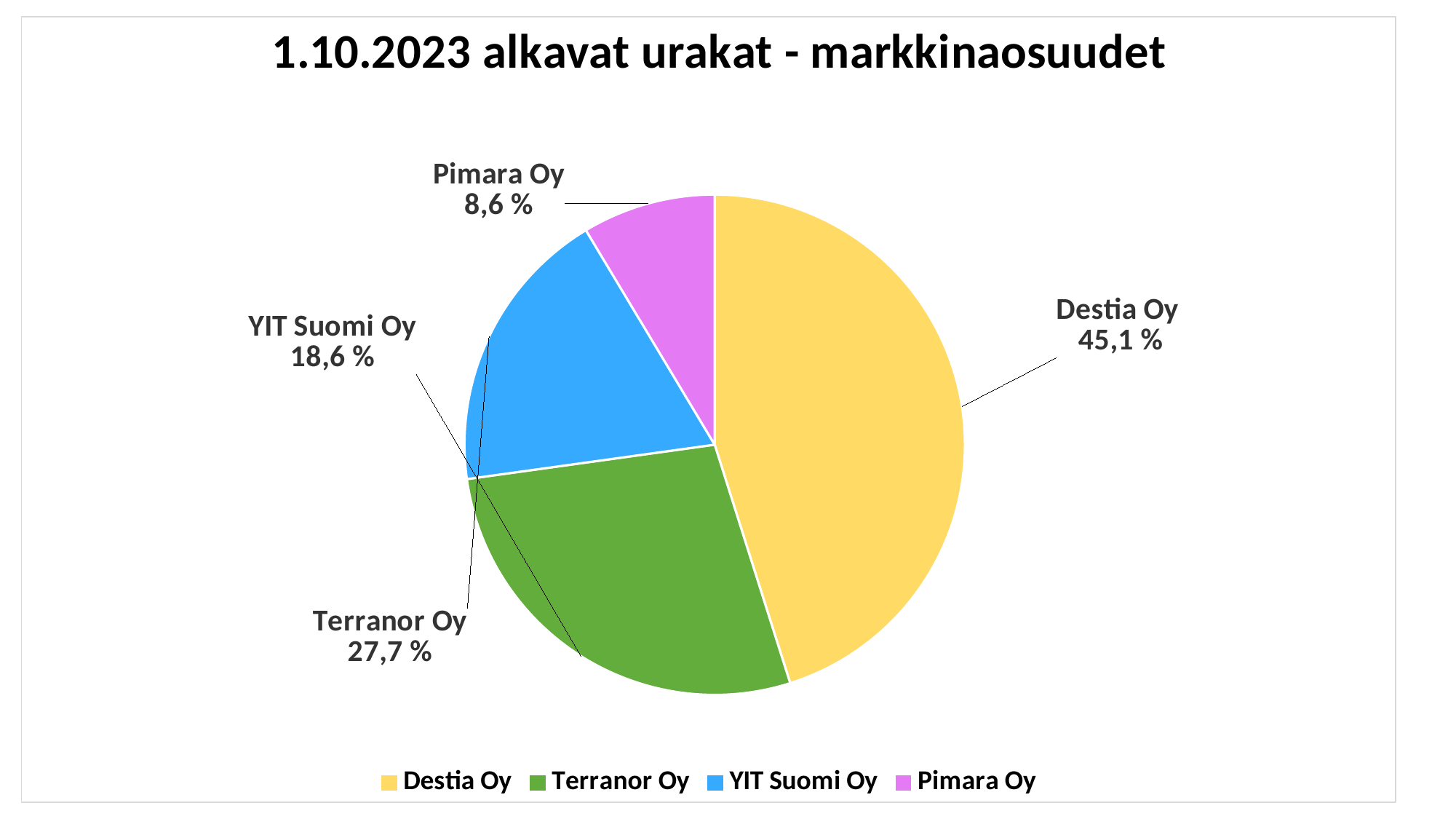
What kind of chart is shown on the slide? Pie chart Which company has the largest slice of the pie? Destia Oy Which has a larger share, YIT Suomi Oy or Terranor Oy? Terranor Oy Which company has the smallest slice of the pie? Pimara Oy What is the title of the chart? 1.10.2023 alkavat urakat - markkinaosuudet What is the market share shown for Destia Oy? 45,1 % Which colour represents YIT Suomi Oy in the chart? Blue What is the market share shown for Pimara Oy? 8,6 % What is the market share shown for Terranor Oy? 27,7 % How many companies are shown in the pie chart? 4 What is the difference in percentage points between Destia Oy and Terranor Oy? 17,4 What is the market share shown for YIT Suomi Oy? 18,6 %